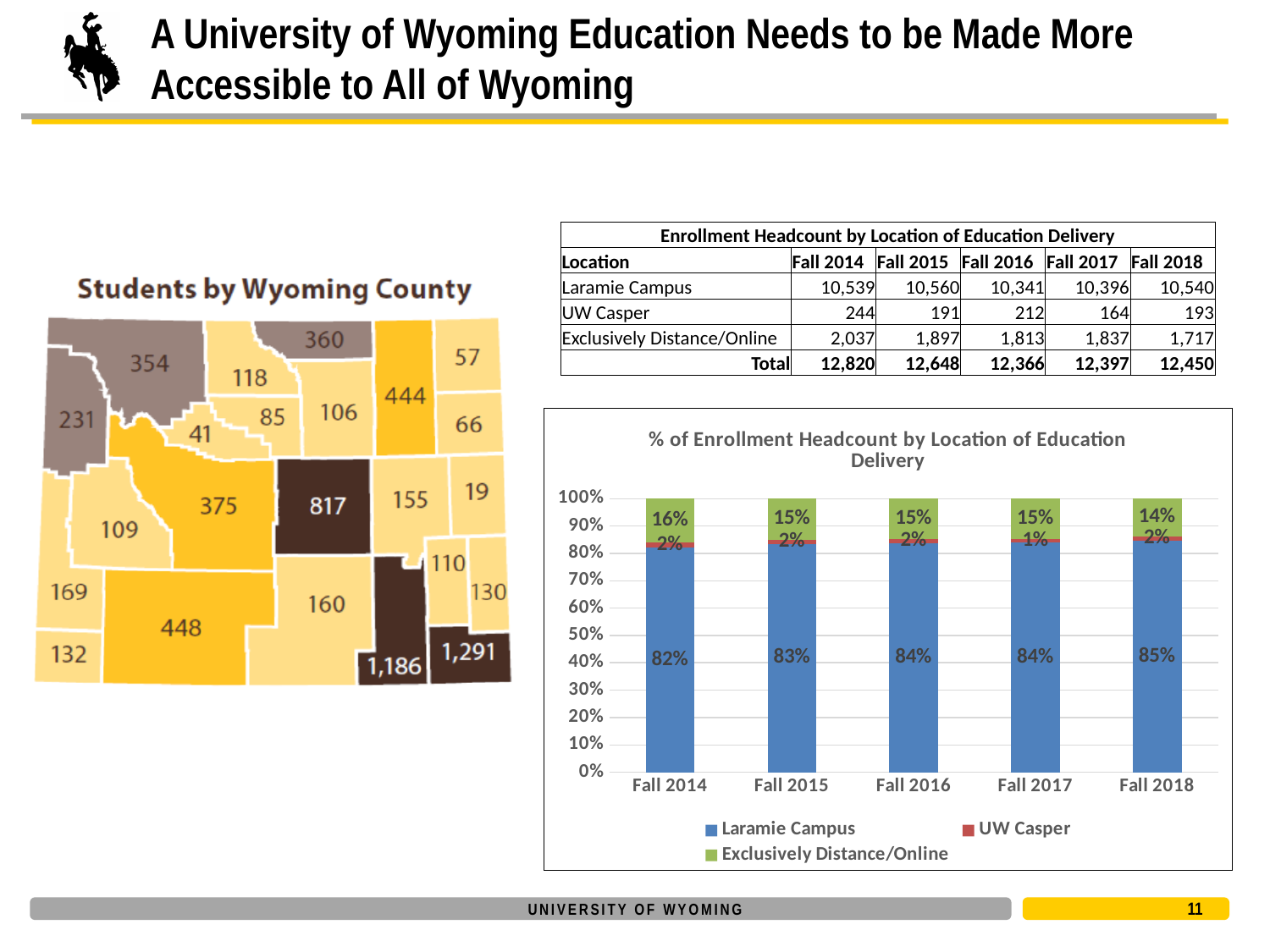
In the '% of Enrollment Headcount by Location of Education Delivery' chart, which year has the highest Laramie Campus share? Fall 2018 In the '% of Enrollment Headcount by Location of Education Delivery' chart, what is the Exclusively Distance/Online value for Fall 2018? 14% How many years (categories) are shown on the x axis of the '% of Enrollment Headcount by Location of Education Delivery' chart? 5 What kind of chart is the '% of Enrollment Headcount by Location of Education Delivery' chart? Stacked bar chart In the '% of Enrollment Headcount by Location of Education Delivery' chart, what is the Laramie Campus value for Fall 2014? 82% How many series does the legend of the '% of Enrollment Headcount by Location of Education Delivery' chart list? 3 In the '% of Enrollment Headcount by Location of Education Delivery' chart, which is larger: the Exclusively Distance/Online share in Fall 2014 or in Fall 2018? Fall 2014 In the '% of Enrollment Headcount by Location of Education Delivery' chart, does the Laramie Campus share rise or fall from Fall 2014 to Fall 2018? Rise In the '% of Enrollment Headcount by Location of Education Delivery' chart, what is the UW Casper value for Fall 2017? 1% In the '% of Enrollment Headcount by Location of Education Delivery' chart, which year has the lowest Exclusively Distance/Online share? Fall 2018 In the '% of Enrollment Headcount by Location of Education Delivery' chart, is the Laramie Campus value for Fall 2016 greater or less than 80%? greater In the '% of Enrollment Headcount by Location of Education Delivery' chart, what is the difference between the Laramie Campus share in Fall 2018 and in Fall 2014? 3%